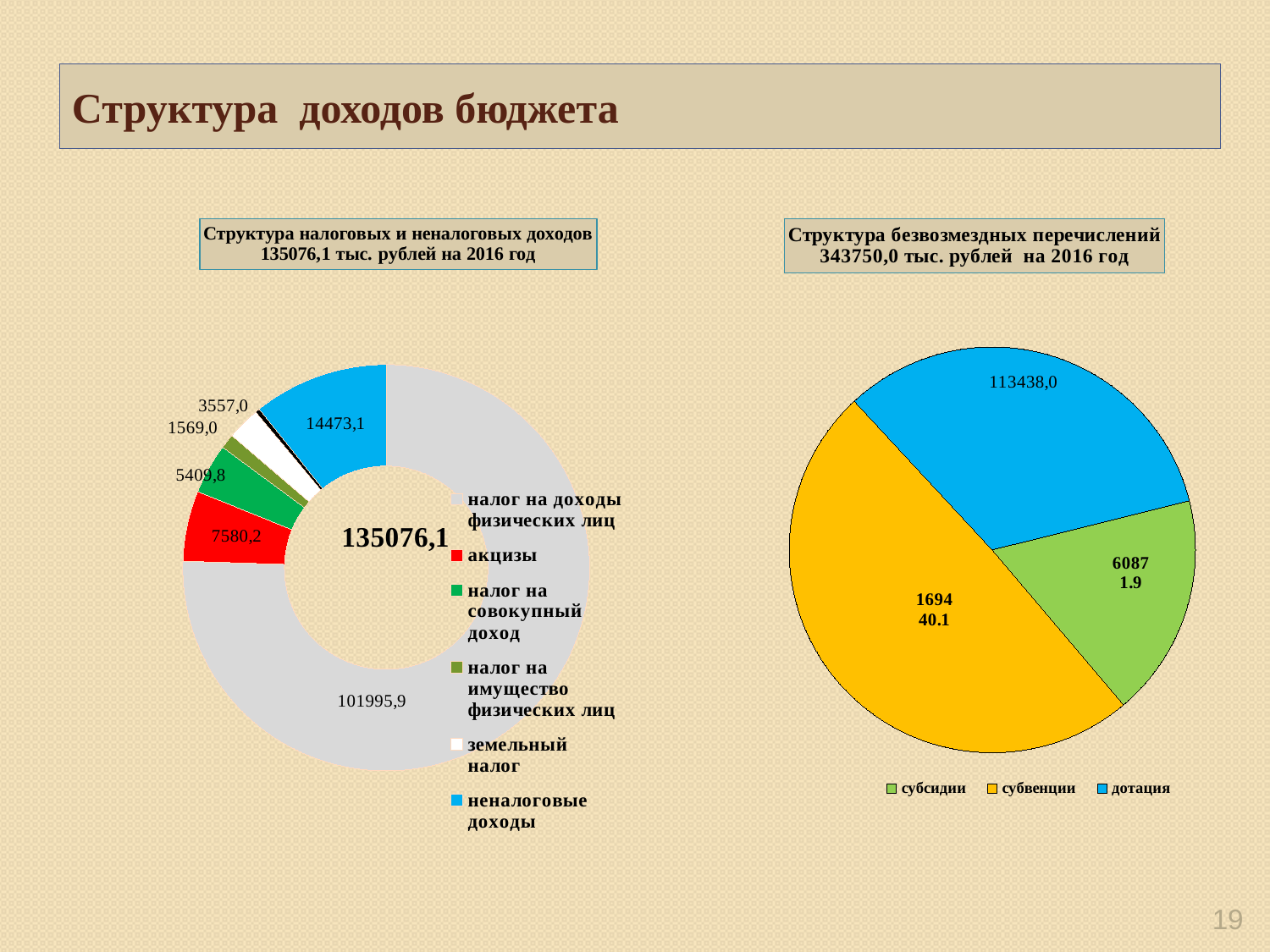
On the left chart (Структура налоговых и неналоговых доходов), which category has the largest value? налог на доходы физических лиц On the left chart (Структура налоговых и неналоговых доходов), what is the value for неналоговые доходы? 14473,1 On the left chart (Структура налоговых и неналоговых доходов), what is the value for налог на доходы физических лиц? 101995,9 On the right chart (Структура безвозмездных перечислений), what is the value for дотация? 113438,0 What kind of chart is the right chart (Структура безвозмездных перечислений)? pie chart On the left chart (Структура налоговых и неналоговых доходов), how many categories does the legend list? 6 On the left chart (Структура налоговых и неналоговых доходов), what total value is shown in the centre of the doughnut? 135076,1 On the right chart (Структура безвозмездных перечислений), which slice is the largest? субвенции On the left chart (Структура налоговых и неналоговых доходов), what is the difference between неналоговые доходы and акцизы? 6892,9 On the left chart (Структура налоговых и неналоговых доходов), which is larger: акцизы or налог на совокупный доход? акцизы On the left chart (Структура налоговых и неналоговых доходов), what is the value for акцизы? 7580,2